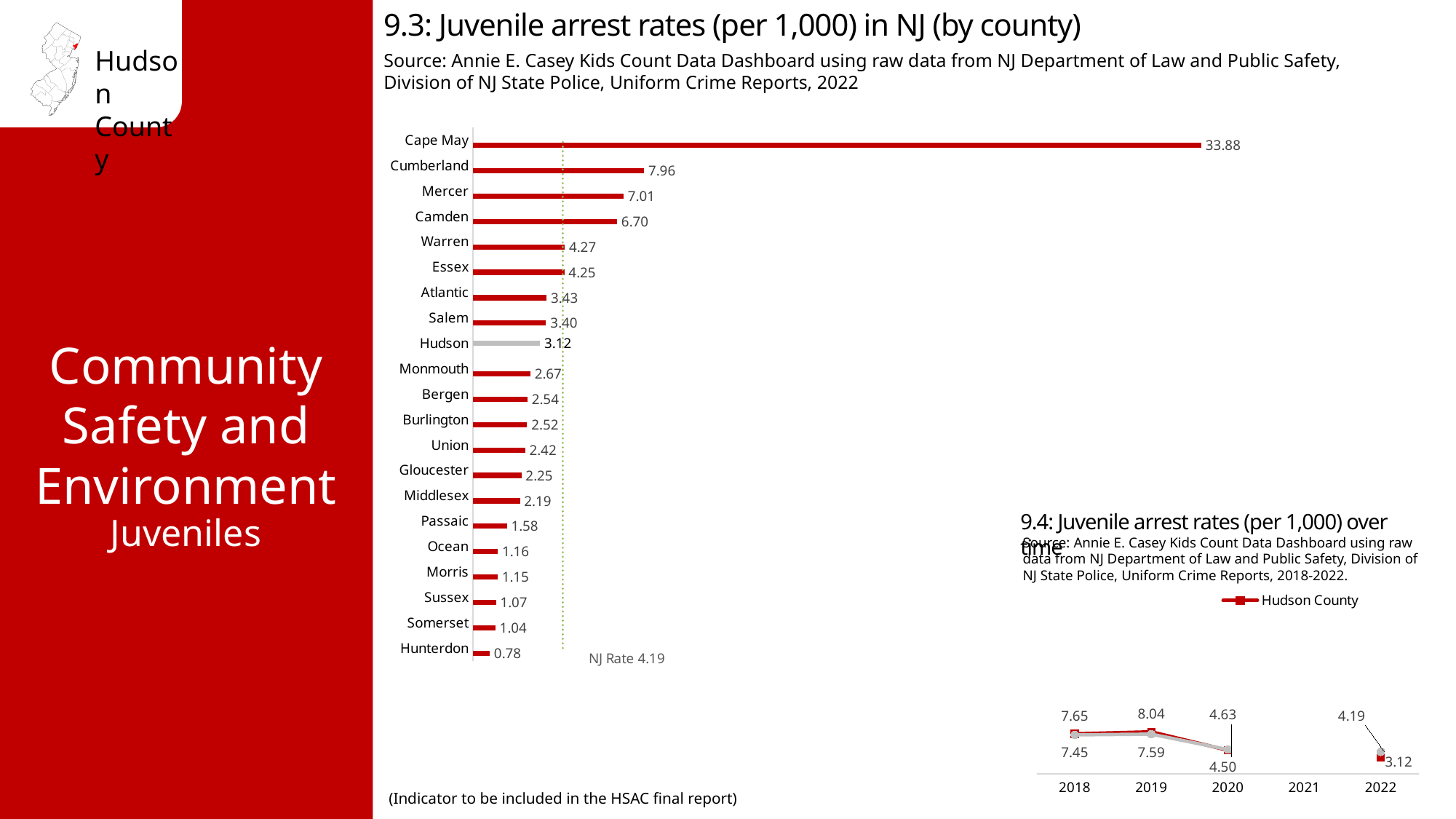
In the chart '9.3: Juvenile arrest rates (per 1,000) in NJ (by county)', what NJ rate is marked by the dotted reference line? 4.19 In the chart '9.3: Juvenile arrest rates (per 1,000) in NJ (by county)', what is the difference between the values for Mercer and Camden? 0.31 In the chart '9.3: Juvenile arrest rates (per 1,000) in NJ (by county)', what is the value for Cumberland? 7.96 In the chart '9.4: Juvenile arrest rates (per 1,000) over time', what is the value for Hudson County in 2022? 3.12 In the chart '9.3: Juvenile arrest rates (per 1,000) in NJ (by county)', which county has the highest rate? Cape May In the chart '9.4: Juvenile arrest rates (per 1,000) over time', how many years are shown on the x axis? 5 In the chart '9.3: Juvenile arrest rates (per 1,000) in NJ (by county)', how many counties are shown? 21 In the chart '9.3: Juvenile arrest rates (per 1,000) in NJ (by county)', which county has the lowest rate? Hunterdon In the chart '9.3: Juvenile arrest rates (per 1,000) in NJ (by county)', which is larger, the value for Warren or the value for Atlantic? Warren What kind of chart is '9.3: Juvenile arrest rates (per 1,000) in NJ (by county)'? bar chart In the chart '9.4: Juvenile arrest rates (per 1,000) over time', how many series does the legend list? 1 In the chart '9.3: Juvenile arrest rates (per 1,000) in NJ (by county)', what is the value for Hudson? 3.12